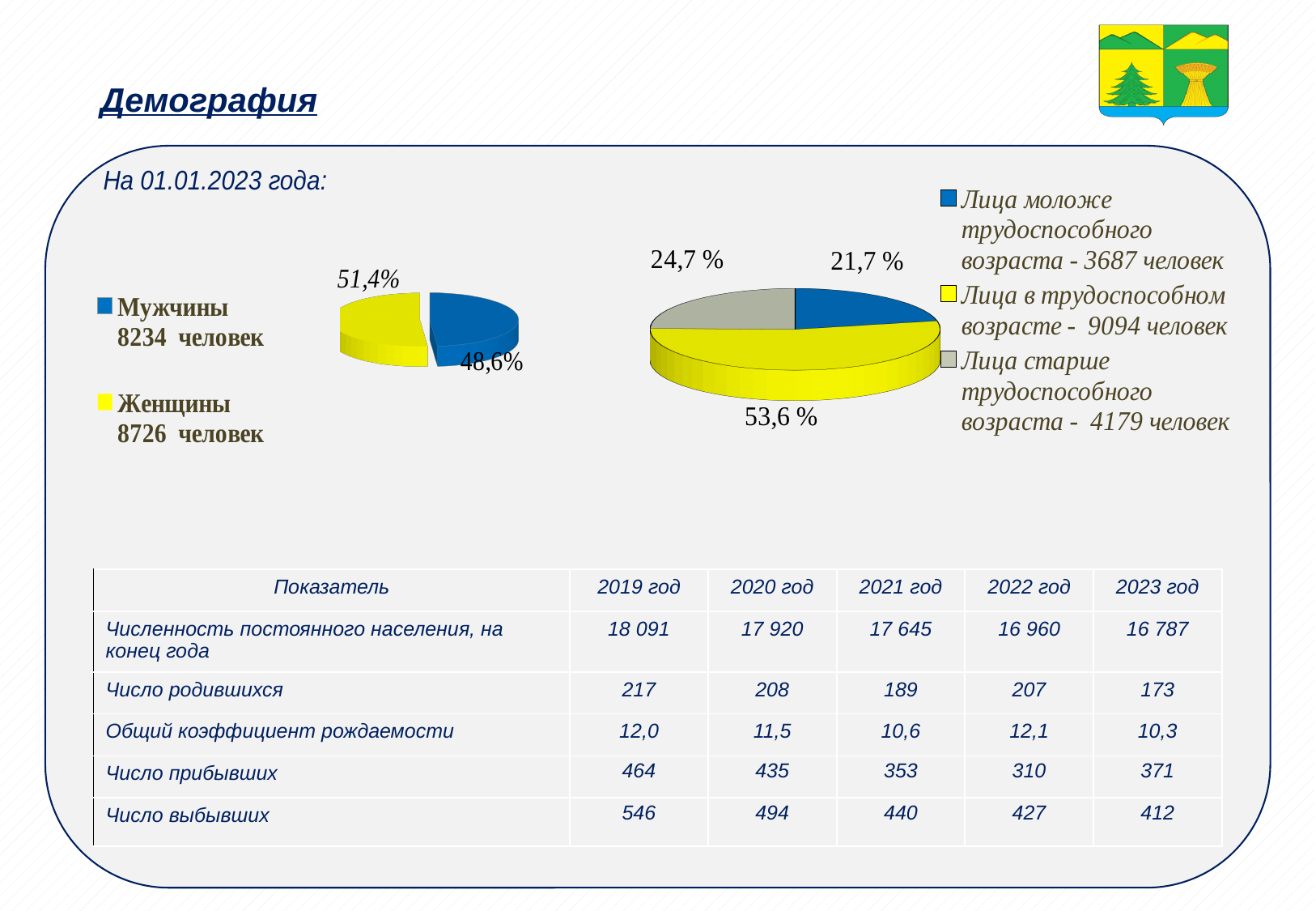
How many entries does the legend of the right pie chart list? 3 In the right pie chart, what share is labelled for Лица моложе трудоспособного возраста? 21,7 % In the left pie chart, what share is labelled for Мужчины? 48,6% In the right pie chart, how many people does the legend give for Лица старше трудоспособного возраста? 4179 человек In the right pie chart, which group has the smallest slice? Лица моложе трудоспособного возраста How many slices does the left pie chart have? 2 What type of chart is the left chart showing men and women? pie chart In the left pie chart, what share is labelled for Женщины? 51,4% In the left pie chart, which group has the larger slice, Мужчины or Женщины? Женщины In the right pie chart, what is the difference in percentage points between the shares for Лица старше трудоспособного возраста and Лица моложе трудоспособного возраста? 3,0 % In the left pie chart, how many people does the legend give for Мужчины? 8234 человек